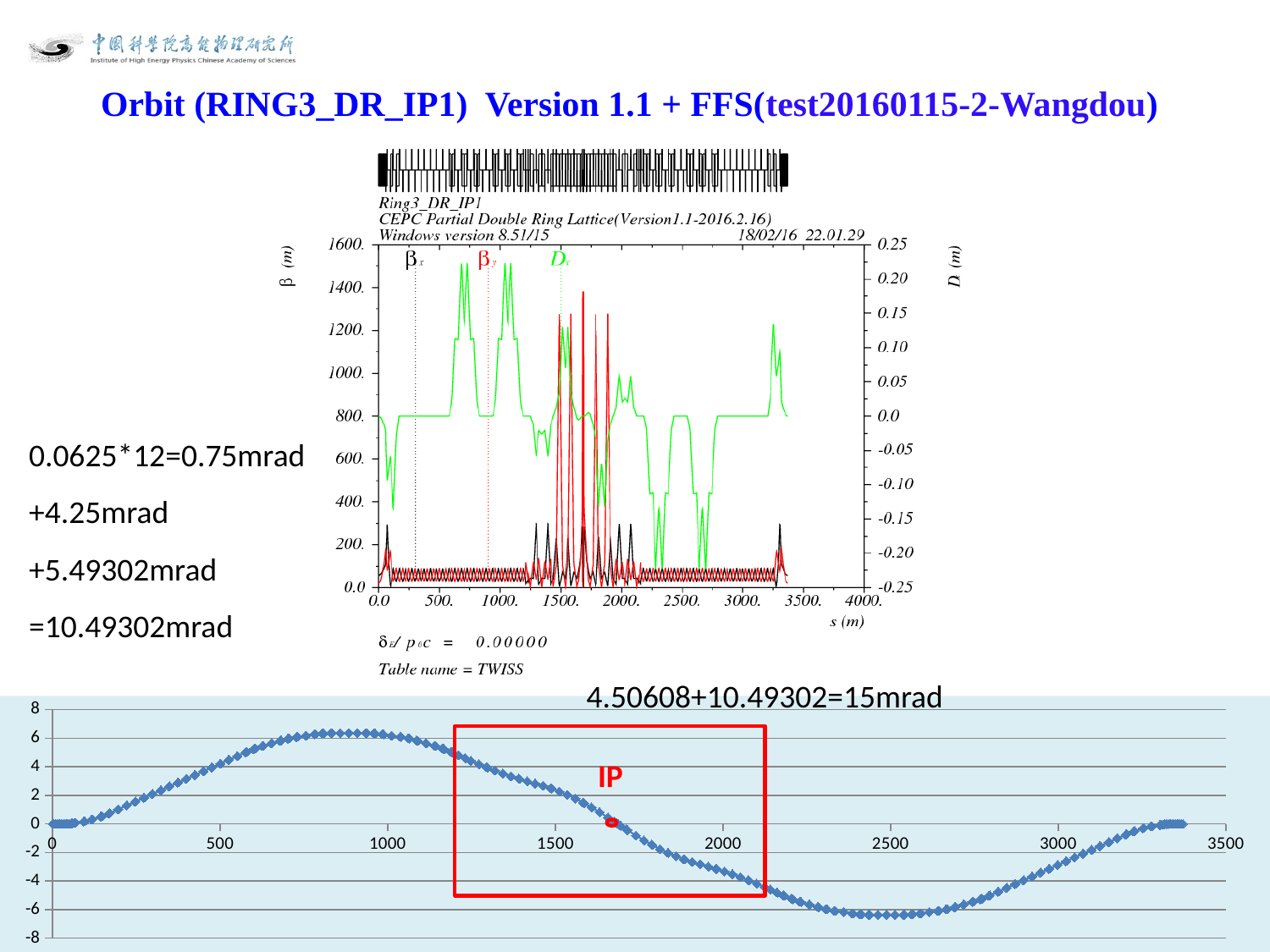
In the bottom chart, is the value at x = 500 greater or less than 2? greater In the bottom chart, is the value at the point marked IP greater or less than 2? less In the bottom chart, do the values rise or fall as x goes from 0 to 1000? rise In the bottom chart, what label is written inside the red box? IP In the top chart (Ring3_DR_IP1), how many series does the legend list? 3 What kind of chart is the bottom chart on the slide? scatter chart In the bottom chart, is the value at x = 2500 greater or less than -4? less In the top chart (Ring3_DR_IP1), what colour is the Dx curve? green In the bottom chart, do the values rise or fall as x goes from 1000 to 2500? fall In the bottom chart, which is larger: the value at x = 500 or the value at x = 2000? the value at x = 500